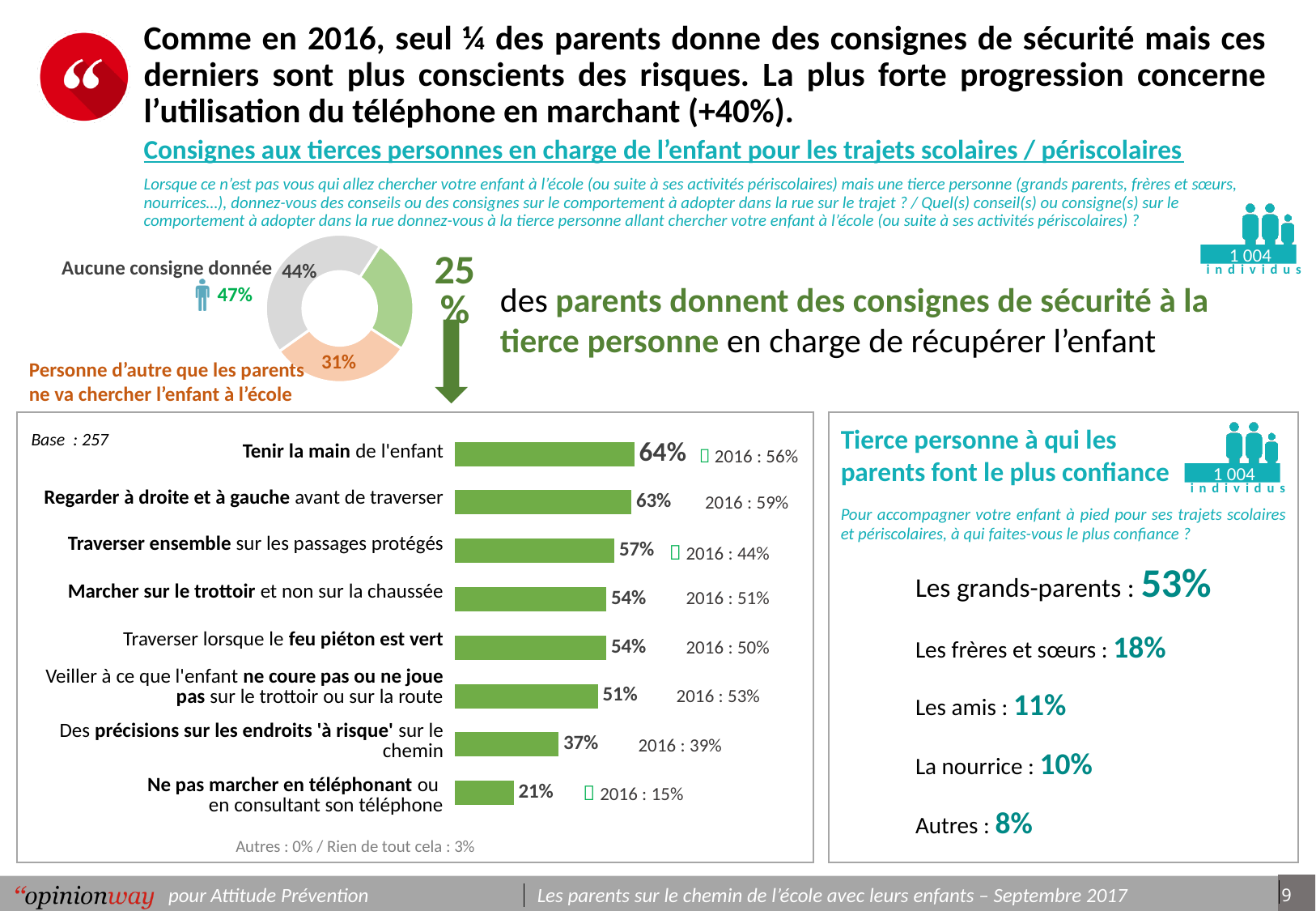
In the bar chart at the bottom left, which category has the lowest value? Ne pas marcher en téléphonant ou en consultant son téléphone In the bar chart at the bottom left, what is the value for "Ne pas marcher en téléphonant ou en consultant son téléphone"? 21% What kind of chart is the chart at the bottom left of the slide? Bar chart In the bar chart at the bottom left, by how many percentage points did "Traverser ensemble sur les passages protégés" increase from its 2016 value (44%) to its current value (57%)? 13 percentage points In the bar chart at the bottom left, which category has the highest value? Tenir la main de l'enfant In the donut chart at the top left, which segment is the largest? Aucune consigne donnée (44%) In the donut chart at the top left, what is the value for "Aucune consigne donnée"? 44% In the bar chart at the bottom left, which is larger: the value for "Marcher sur le trottoir et non sur la chaussée" or the value for "Des précisions sur les endroits 'à risque' sur le chemin"? Marcher sur le trottoir et non sur la chaussée How many categories (bars) are shown in the bar chart at the bottom left? 8 In the donut chart at the top left, what share corresponds to "Personne d'autre que les parents ne va chercher l'enfant à l'école"? 31% In the bar chart at the bottom left, what is the value for "Tenir la main de l'enfant"? 64% In the bar chart at the bottom left, what was the 2016 value shown next to "Regarder à droite et à gauche avant de traverser"? 2016 : 59%